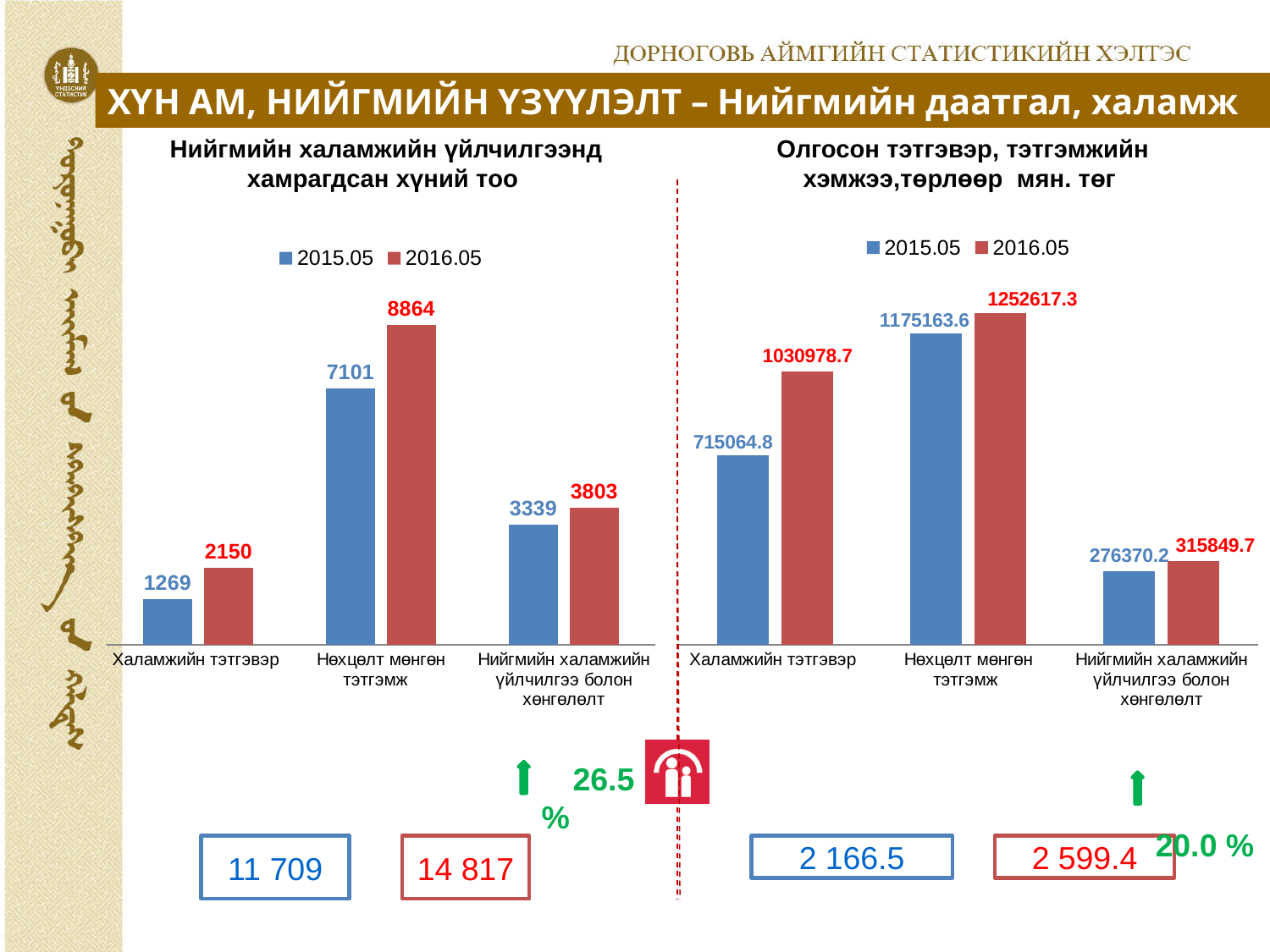
In the right chart (Олгосон тэтгэвэр, тэтгэмжийн хэмжээ, төрлөөр мян. төг), what is the 2015.05 value for Халамжийн тэтгэвэр? 715064.8 In the right chart (Олгосон тэтгэвэр, тэтгэмжийн хэмжээ, төрлөөр мян. төг), which category has the highest 2016.05 value? Нөхцөлт мөнгөн тэтгэмж In the left chart (Нийгмийн халамжийн үйлчилгээнд хамрагдсан хүний тоо), what is the 2015.05 value for Нөхцөлт мөнгөн тэтгэмж? 7101 In the left chart (Нийгмийн халамжийн үйлчилгээнд хамрагдсан хүний тоо), which category has the highest 2016.05 value? Нөхцөлт мөнгөн тэтгэмж In the left chart (Нийгмийн халамжийн үйлчилгээнд хамрагдсан хүний тоо), what is the 2016.05 value for Халамжийн тэтгэвэр? 2150 In the left chart (Нийгмийн халамжийн үйлчилгээнд хамрагдсан хүний тоо), what is the difference between the 2016.05 and 2015.05 values for Нөхцөлт мөнгөн тэтгэмж? 1763 In the right chart (Олгосон тэтгэвэр, тэтгэмжийн хэмжээ, төрлөөр мян. төг), which is larger for Халамжийн тэтгэвэр: the 2015.05 value or the 2016.05 value? 2016.05 How many series does the legend of the right chart (Олгосон тэтгэвэр, тэтгэмжийн хэмжээ, төрлөөр мян. төг) list? 2 In the left chart (Нийгмийн халамжийн үйлчилгээнд хамрагдсан хүний тоо), how many categories are shown on the x axis? 3 In the right chart (Олгосон тэтгэвэр, тэтгэмжийн хэмжээ, төрлөөр мян. төг), what is the 2016.05 value for Нийгмийн халамжийн үйлчилгээ болон хөнгөлөлт? 315849.7 In the left chart (Нийгмийн халамжийн үйлчилгээнд хамрагдсан хүний тоо), which category has the lowest 2015.05 value? Халамжийн тэтгэвэр What type of chart is the left chart (Нийгмийн халамжийн үйлчилгээнд хамрагдсан хүний тоо)? Bar chart